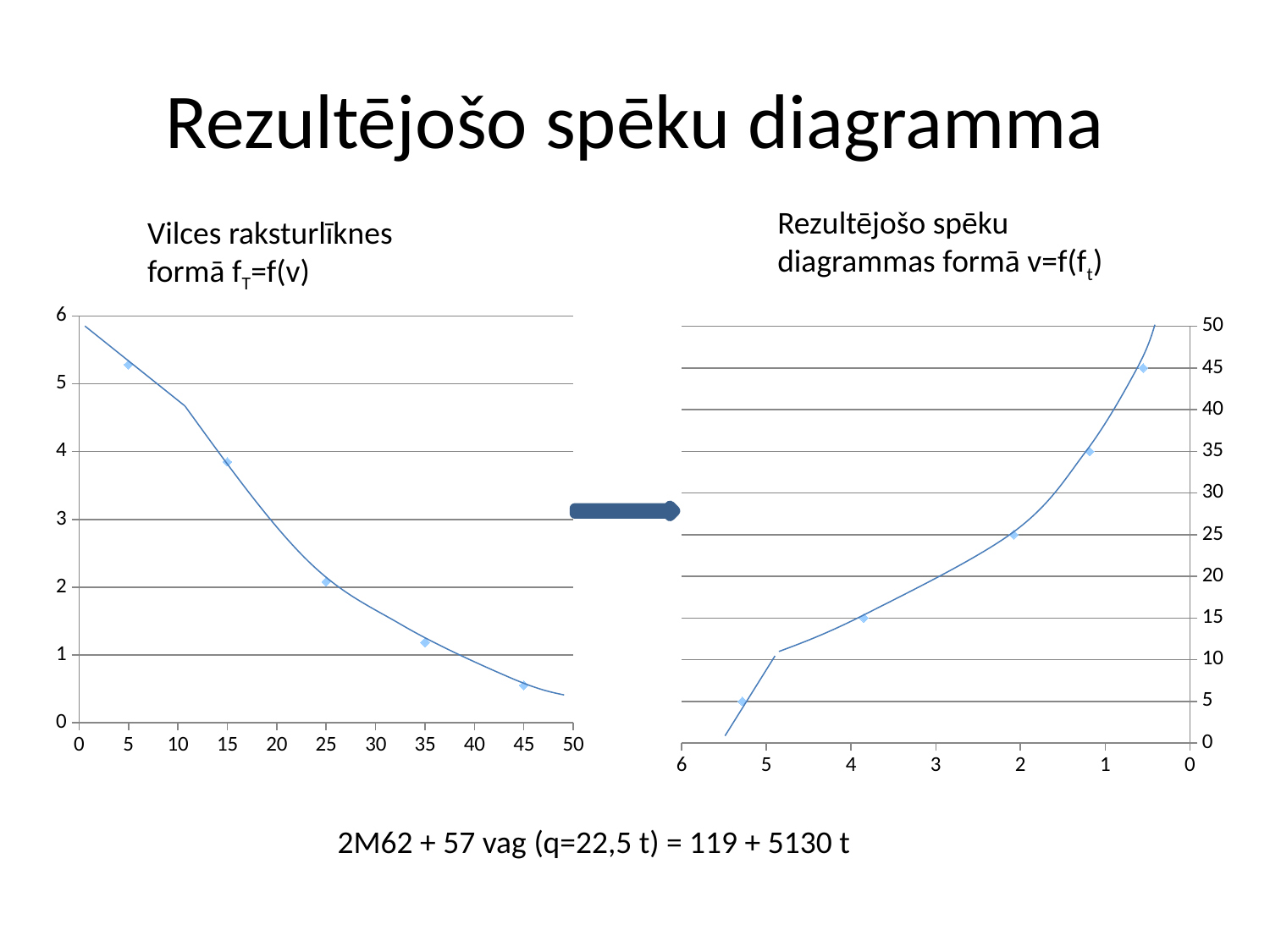
On the left chart "Vilces raksturlīknes formā fT=f(v)", at which x value is the plotted point lowest? 45 On the left chart "Vilces raksturlīknes formā fT=f(v)", do the values rise or fall as the x axis increases from 0 to 50? fall How many data point markers are plotted on the left chart "Vilces raksturlīknes formā fT=f(v)"? 5 How many charts are shown on the slide? 2 On the left chart "Vilces raksturlīknes formā fT=f(v)", at which x value is the plotted point highest? 5 What kind of chart is the left chart titled "Vilces raksturlīknes formā fT=f(v)"? line chart On the left chart "Vilces raksturlīknes formā fT=f(v)", is the value at x = 5 greater or less than 5? greater On the left chart "Vilces raksturlīknes formā fT=f(v)", is the value at x = 45 greater or less than 1? less On the left chart "Vilces raksturlīknes formā fT=f(v)", which is larger: the value at x = 15 or the value at x = 35? x = 15 How many data point markers are plotted on the right chart "Rezultējošo spēku diagrammas formā v=f(ft)"? 5 On the right chart "Rezultējošo spēku diagrammas formā v=f(ft)", does the curve rise or fall from left to right? rise On the right chart "Rezultējošo spēku diagrammas formā v=f(ft)", is the horizontal-axis value of the point at v = 45 greater or less than 1? less